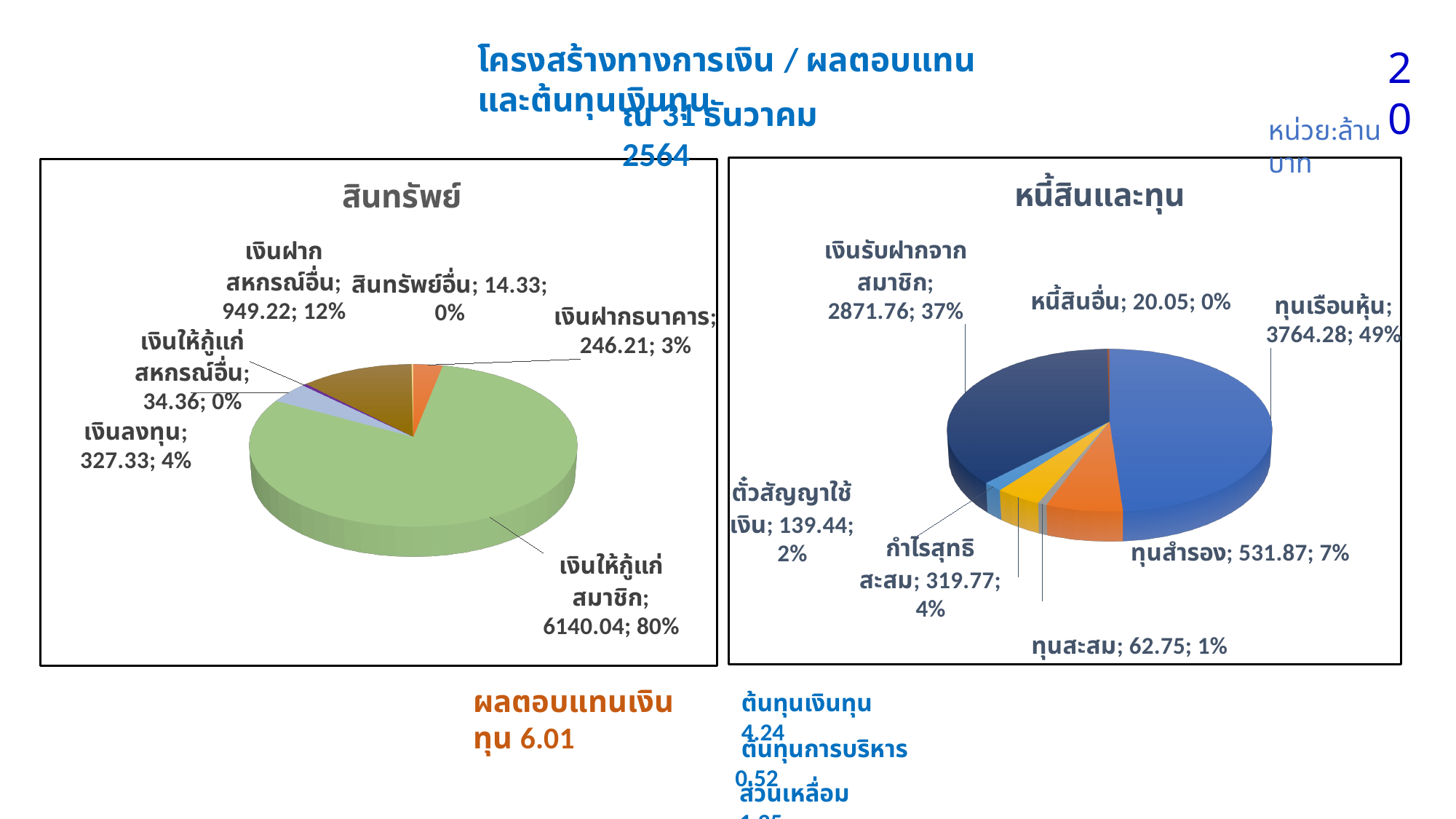
In the "สินทรัพย์" pie chart, which category is the largest? เงินให้กู้แก่สมาชิก In the "สินทรัพย์" pie chart, how many categories are shown? 6 In the "สินทรัพย์" pie chart, what is the value for เงินให้กู้แก่สมาชิก? 6140.04 In the "หนี้สินและทุน" pie chart, how many categories are shown? 7 In the "สินทรัพย์" pie chart, which category has the smallest value? สินทรัพย์อื่น In the "หนี้สินและทุน" pie chart, which category has the smallest value? หนี้สินอื่น In the "หนี้สินและทุน" pie chart, what is the value for ทุนเรือนหุ้น? 3764.28 In the "สินทรัพย์" pie chart, what is the difference between เงินลงทุน and เงินฝากธนาคาร? 81.12 In the "หนี้สินและทุน" pie chart, which is larger, ทุนสำรอง or กำไรสุทธิสะสม? ทุนสำรอง In the "หนี้สินและทุน" pie chart, what share of the pie does เงินรับฝากจากสมาชิก represent? 37% In the "สินทรัพย์" pie chart, what share of the pie does เงินฝากสหกรณ์อื่น represent? 12% What type of chart is used for "หนี้สินและทุน"? Pie chart